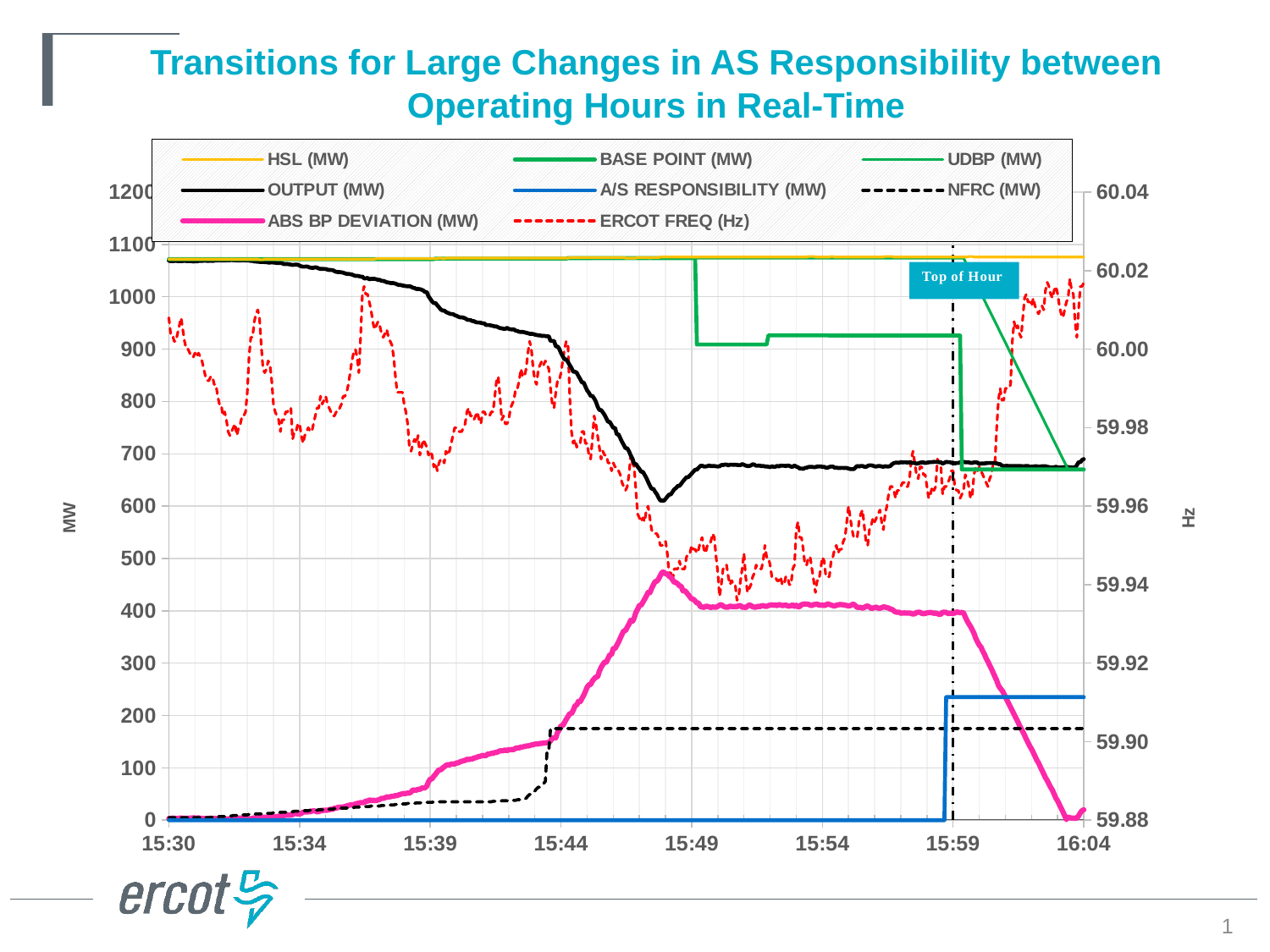
Is the value of OUTPUT (MW) at 15:54 greater or less than 700? less What is the title of the slide containing the chart? Transitions for Large Changes in AS Responsibility between Operating Hours in Real-Time Is the value of A/S RESPONSIBILITY (MW) at 16:04 greater or less than 200? greater How many series does the chart legend list? 8 What label is shown in the annotation box next to the vertical dash-dot line at 15:59? Top of Hour What kind of chart is shown on the slide? line chart Is the value of NFRC (MW) at 15:54 greater or less than 200? less Does the OUTPUT (MW) series rise or fall between 15:30 and 15:49? fall Does the ABS BP DEVIATION (MW) series rise or fall between 15:59 and 16:04? fall